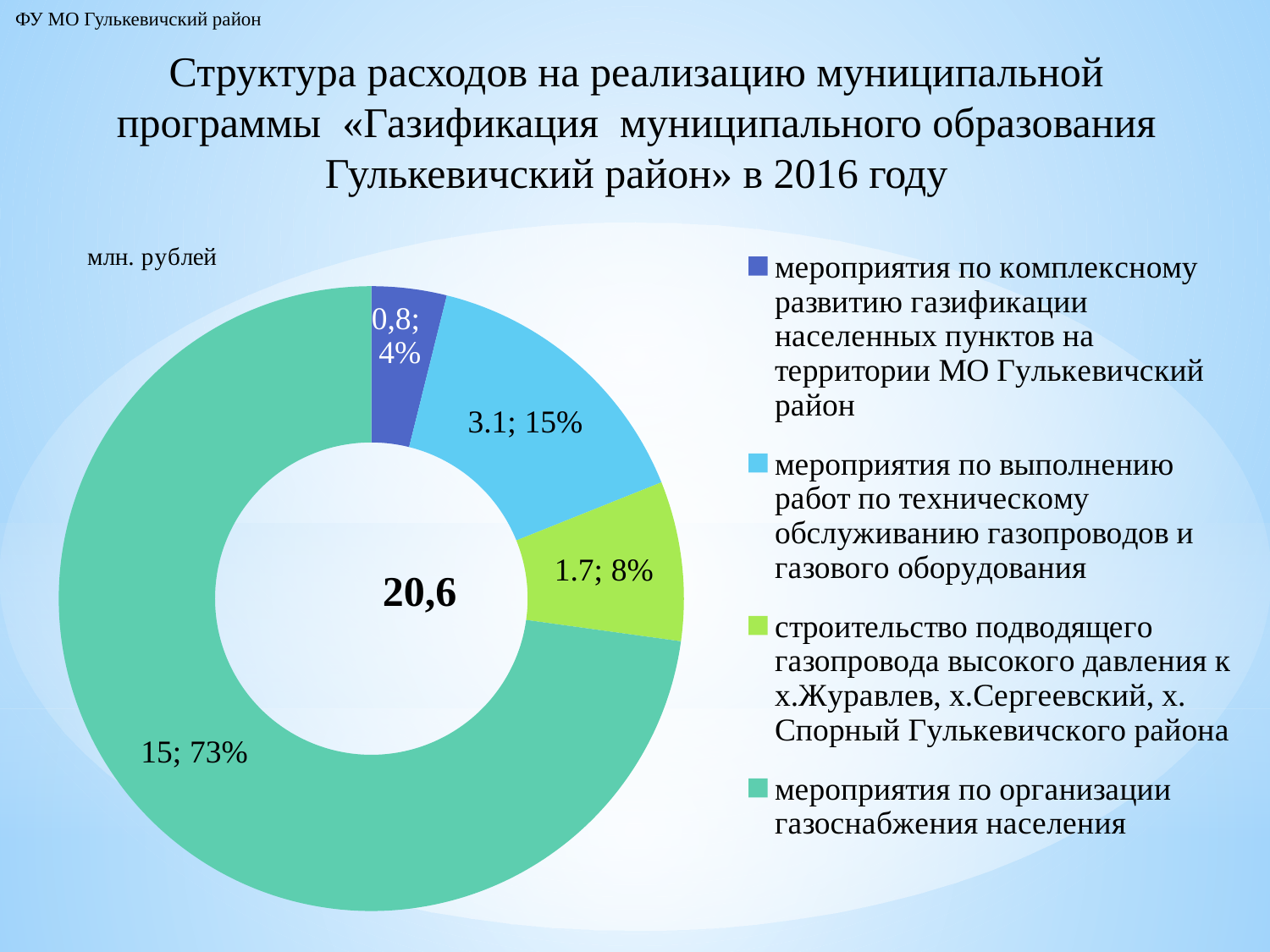
What percentage share does the slice «строительство подводящего газопровода высокого давления» have? 8% What value is shown for the slice «строительство подводящего газопровода высокого давления к х.Журавлев, х.Сергеевский, х. Спорный Гулькевичского района»? 1.7 What kind of chart is shown on the slide? doughnut chart Which is larger: the value for «мероприятия по выполнению работ по техническому обслуживанию газопроводов» or the value for «строительство подводящего газопровода высокого давления»? мероприятия по выполнению работ по техническому обслуживанию газопроводов What value is shown for the slice «мероприятия по организации газоснабжения населения»? 15 What is the difference between the value for «мероприятия по организации газоснабжения населения» and the value for «мероприятия по выполнению работ по техническому обслуживанию газопроводов и газового оборудования»? 11.9 How many entries does the legend list? 4 Which category has the largest slice in the chart? мероприятия по организации газоснабжения населения Which category has the smallest slice in the chart? мероприятия по комплексному развитию газификации населенных пунктов на территории МО Гулькевичский район What value is shown for the slice «мероприятия по выполнению работ по техническому обслуживанию газопроводов и газового оборудования»? 3.1 What value is shown for the slice «мероприятия по комплексному развитию газификации населенных пунктов на территории МО Гулькевичский район»? 0,8 What percentage share does the slice «мероприятия по организации газоснабжения населения» have? 73%